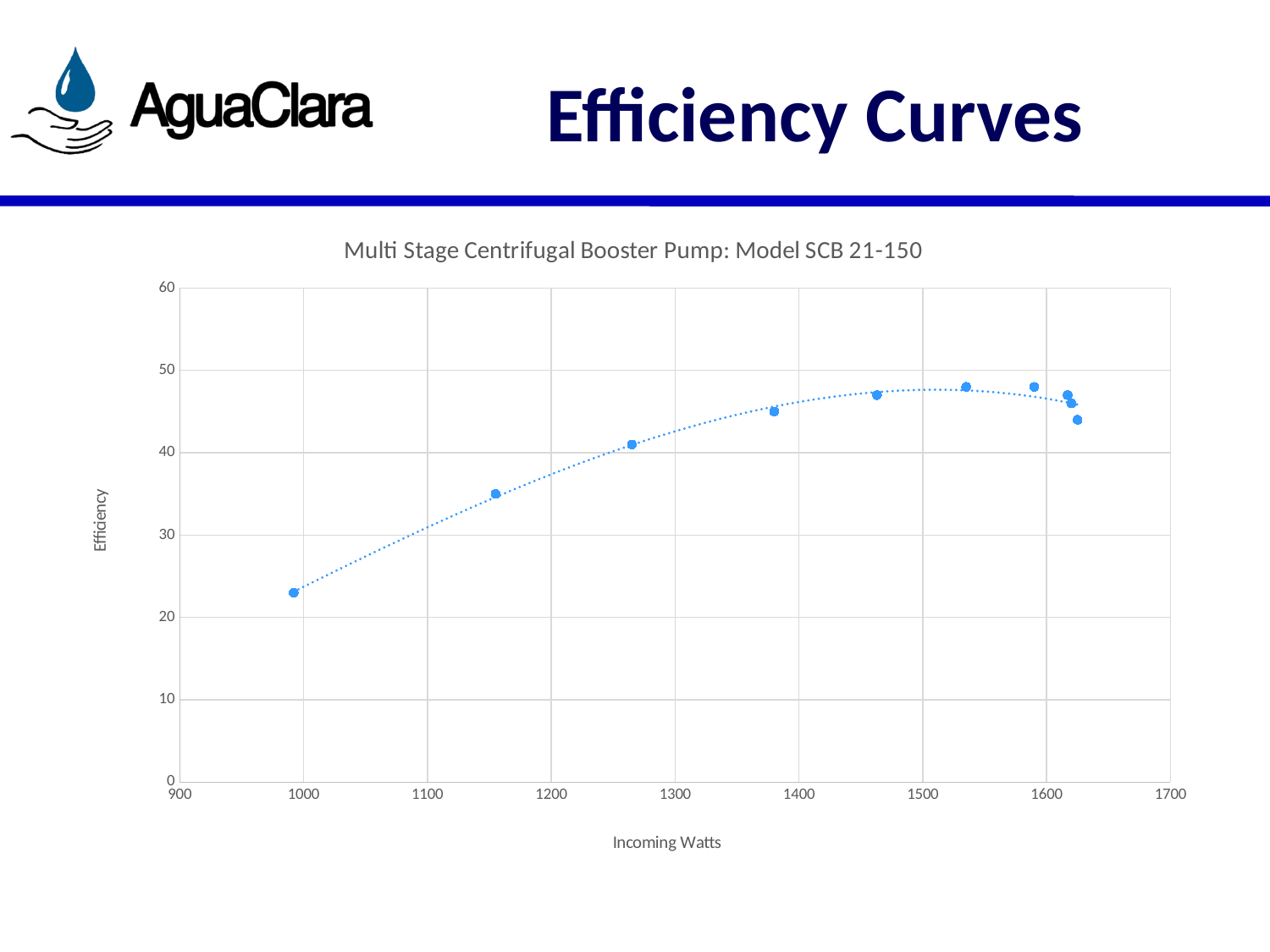
Is the efficiency of the point at about 1000 incoming watts greater or less than 30? less What is the title of the chart? Multi Stage Centrifugal Booster Pump: Model SCB 21-150 Is the efficiency of the point at about 1380 incoming watts greater or less than 40? greater Is the efficiency of the point at about 1150 incoming watts greater or less than 40? less Which has the higher efficiency: the point at about 1000 incoming watts or the point at about 1500 incoming watts? the point at about 1500 incoming watts Does efficiency rise or fall as incoming watts increase from 1000 to 1400? rise What is the label of the x axis? Incoming Watts Is the point with the lowest efficiency at the lowest or the highest incoming watts? lowest What kind of chart is shown on the slide? scatter chart